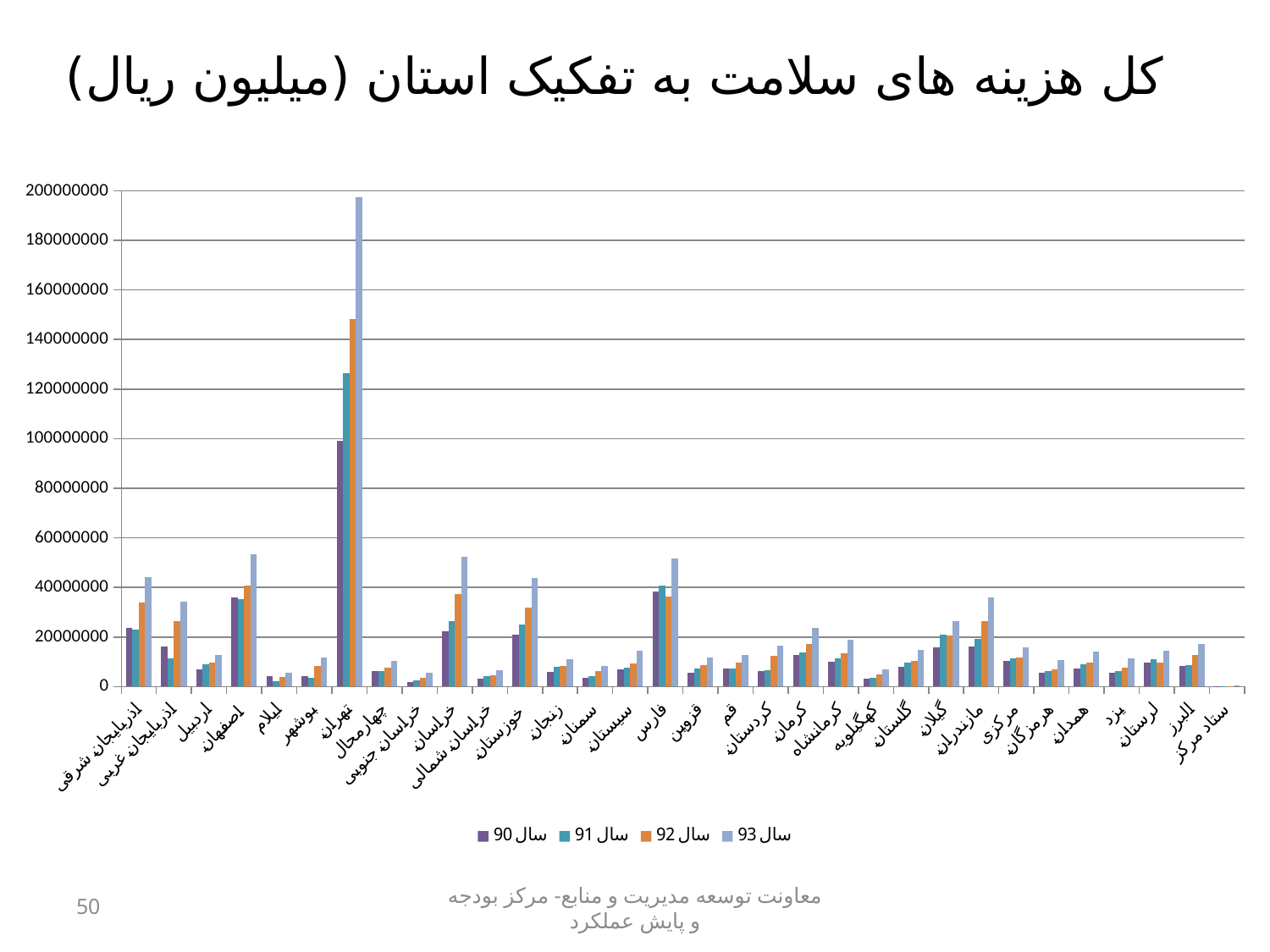
Which province has the highest value for سال 93? تهران Which province has the highest value for سال 90? تهران Is the value for اصفهان in سال 93 greater or less than 40000000? greater Which is larger for سال 92: اصفهان or آذربایجان شرقی? اصفهان What type of chart is shown on the slide? bar chart Is the value for تهران in سال 91 greater or less than 120000000? greater Is the value for تهران in سال 93 greater or less than 180000000? greater What is the title of the chart? کل هزینه های سلامت به تفکیک استان (میلیون ریال) Which is larger for سال 93: خراسان or خوزستان? خراسان How many series does the legend list? 4